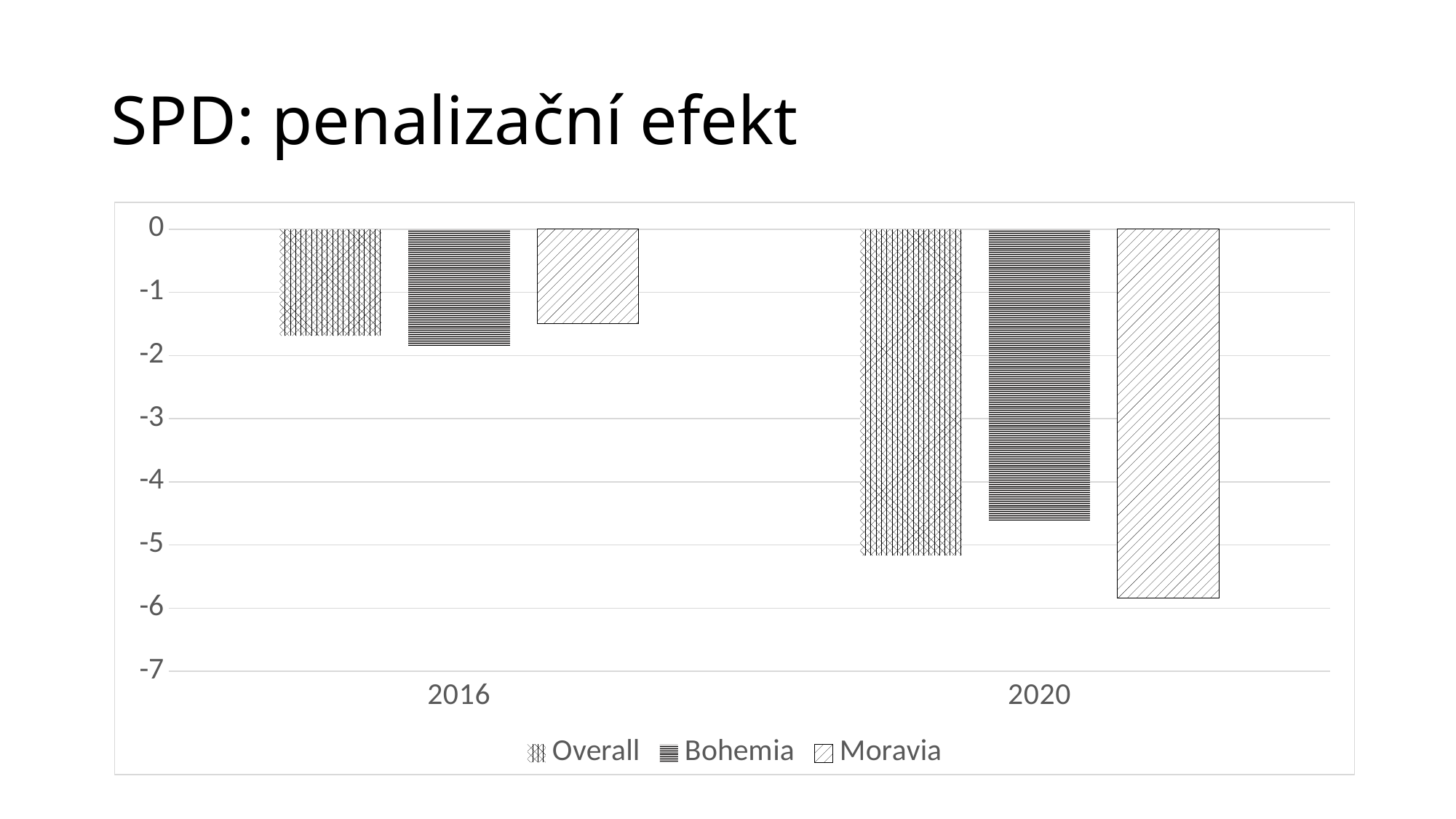
Is the value for Bohemia in 2020 greater or less than -4? less Which is more negative: Moravia in 2020 or Bohemia in 2020? Moravia in 2020 Is the value for Moravia in 2020 greater or less than -5? less Which series has the value closest to zero in 2016? Moravia Which series has the lowest (most negative) value in 2020? Moravia Is the value for Overall in 2016 greater or less than -1? less Do the values for Overall rise or fall from 2016 to 2020? fall How many categories are shown on the x axis? 2 How many series does the legend list? 3 Which series has the lowest (most negative) value in 2016? Bohemia What kind of chart is shown on the slide? bar chart